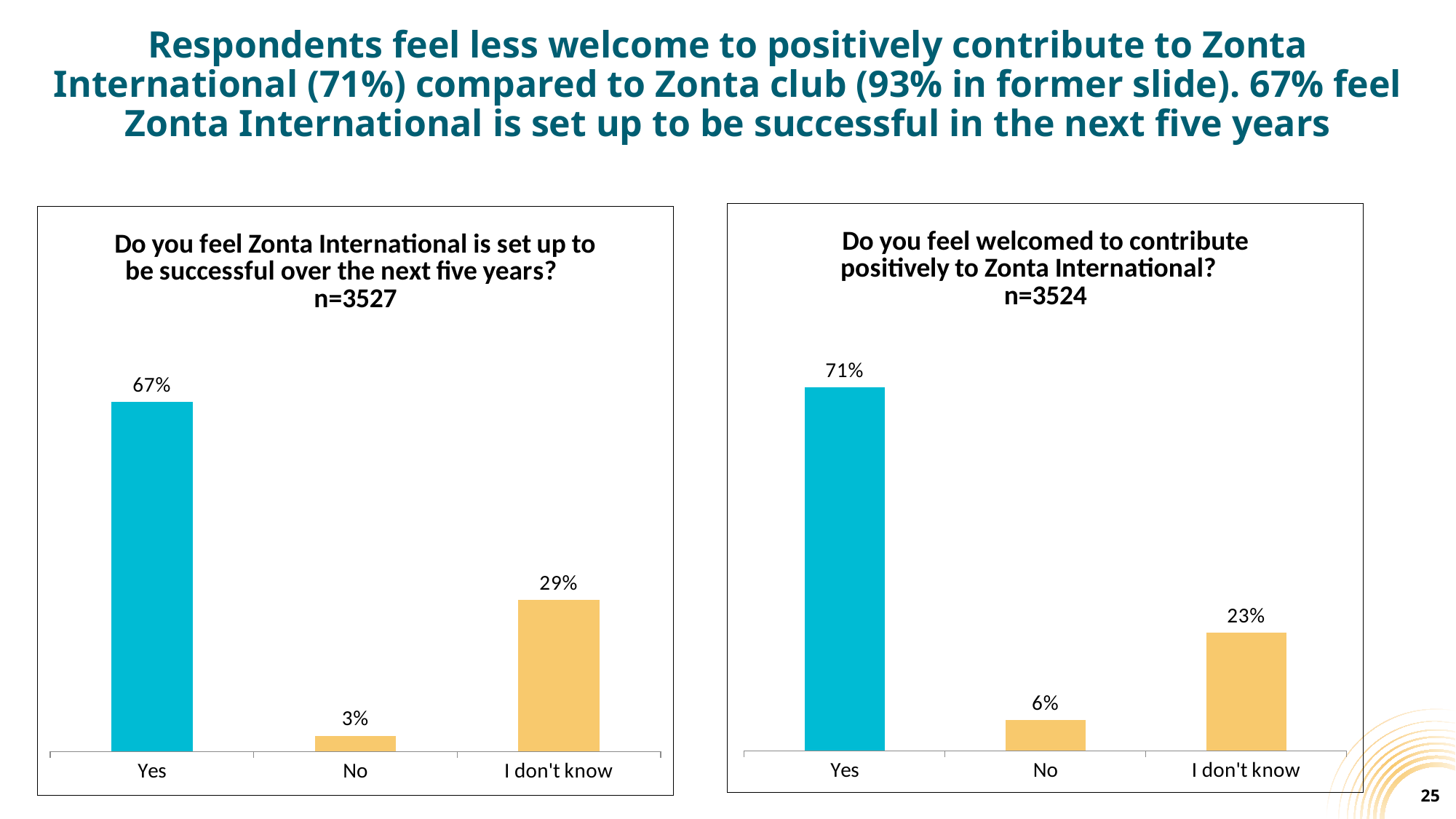
In the left chart (Zonta International set up to be successful over the next five years), which response has the lowest percentage? No What type of chart is the right chart (welcomed to contribute positively to Zonta International)? Bar chart In the right chart (welcomed to contribute positively to Zonta International), what percentage answered No? 6% How many response categories are shown in the left chart (Zonta International set up to be successful over the next five years)? 3 In the left chart (Zonta International set up to be successful over the next five years), what percentage answered No? 3% In the right chart (welcomed to contribute positively to Zonta International), which response has the highest percentage? Yes In the left chart (Zonta International set up to be successful over the next five years), what percentage answered Yes? 67% In the left chart (Zonta International set up to be successful over the next five years), what is the difference between the Yes and I don't know percentages? 38% In the right chart (welcomed to contribute positively to Zonta International), what is the difference between the Yes and No percentages? 65% In the right chart (welcomed to contribute positively to Zonta International), what percentage answered I don't know? 23% Which chart has the larger Yes percentage, the left chart or the right chart? The right chart What is the sample size (n) shown in the title of the right chart (welcomed to contribute positively to Zonta International)? n=3524